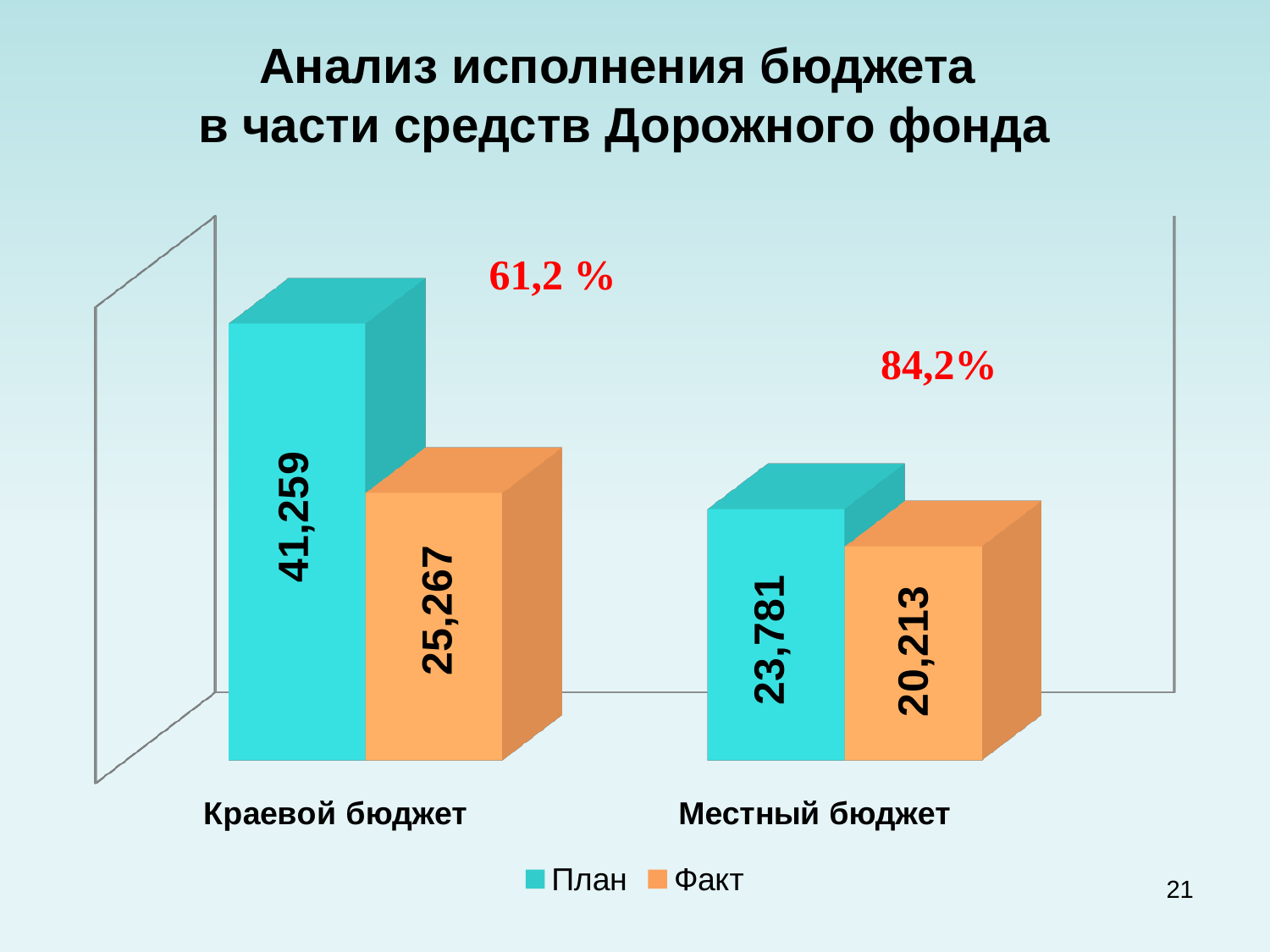
How many series does the legend list? 2 Which category has the highest План value? Краевой бюджет Which is larger for Местный бюджет: the План value or the Факт value? План What is the Факт value for Краевой бюджет? 25,267 What kind of chart is shown on the slide? Bar chart What is the Факт value for Местный бюджет? 20,213 Which category has the lowest Факт value? Местный бюджет What is the difference between the План and Факт values for Краевой бюджет? 15,992 How many categories are shown on the x axis? 2 What is the difference between the План and Факт values for Местный бюджет? 3,568 What is the План value for Краевой бюджет? 41,259 What is the План value for Местный бюджет? 23,781